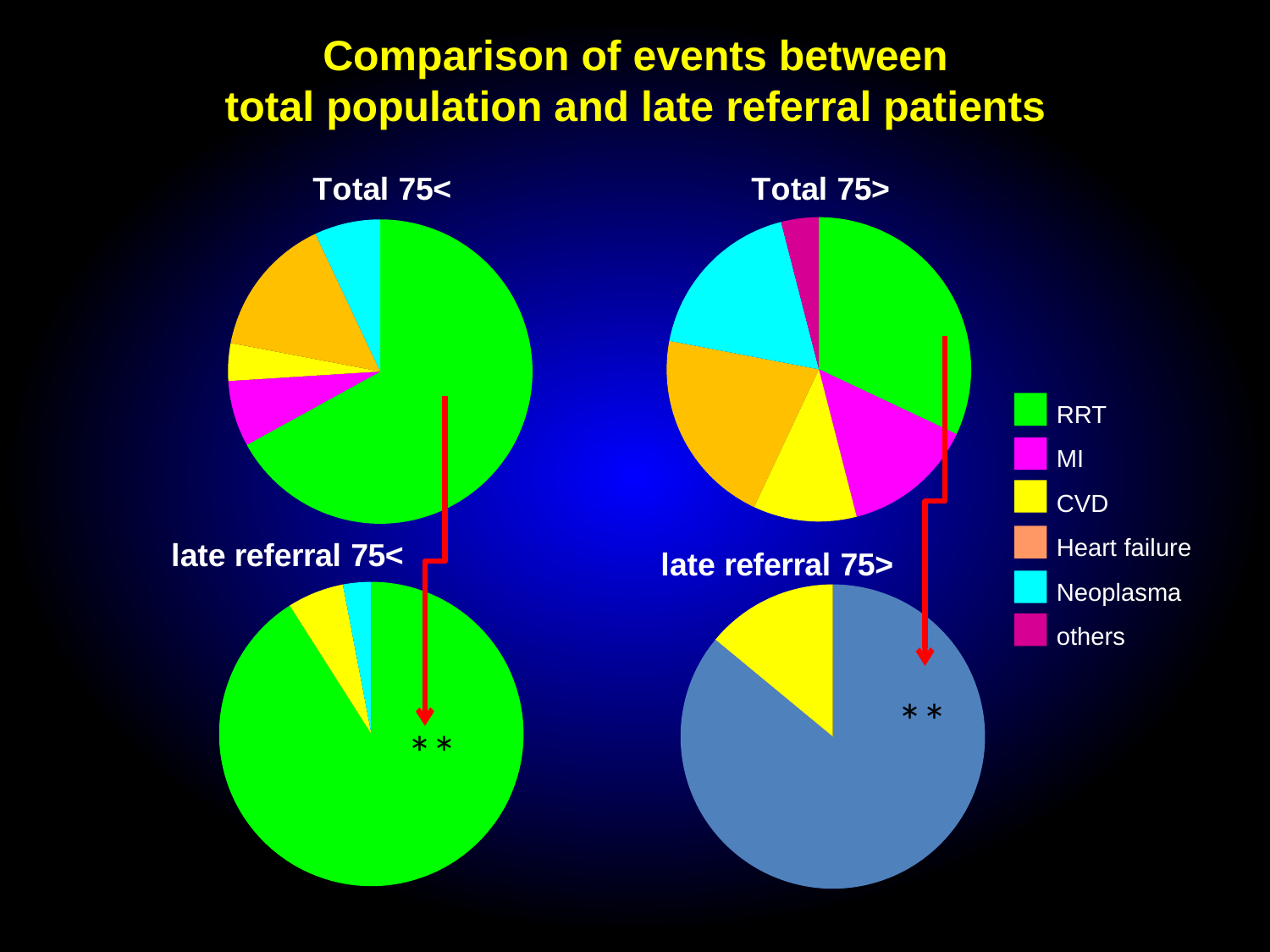
In the "late referral 75<" chart, which category has the largest slice? RRT In the "Total 75>" chart, which category has the largest slice? RRT How many slices does the "Total 75>" pie chart have? 6 In the "Total 75>" chart, which slice is larger, RRT or MI? RRT In the "late referral 75>" chart, which slice is larger, the CVD slice or the blue slice? the blue slice What colour does the legend use for Neoplasma? cyan How many entries does the legend list? 6 In the "Total 75>" chart, which category has the smallest slice? others In the "Total 75<" chart, which category has the largest slice? RRT What kind of chart is the "Total 75<" chart? pie chart How many pie charts are shown on the slide? 4 How many slices does the "late referral 75<" pie chart have? 3